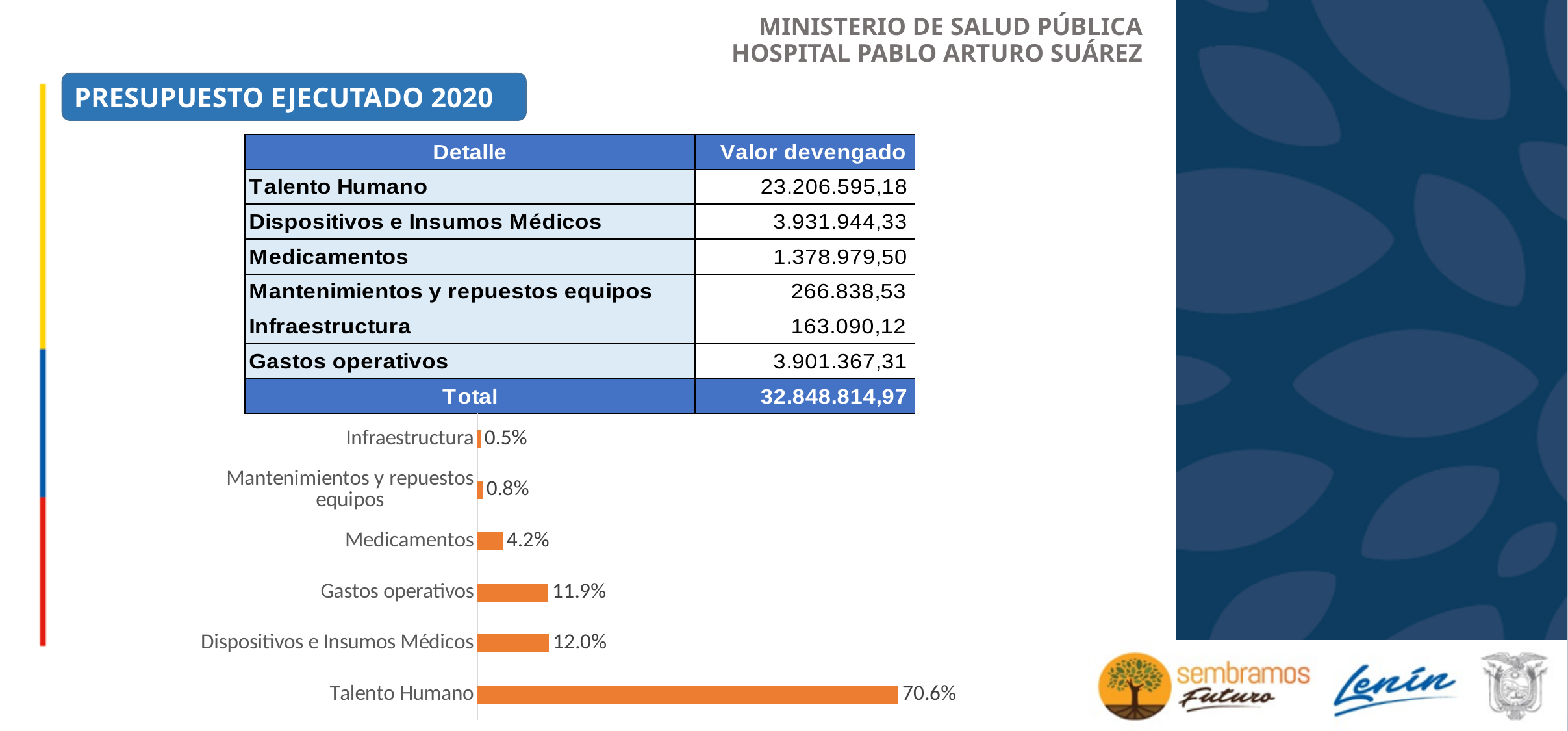
Which category has the highest percentage in the bar chart? Talento Humano How many categories are shown in the bar chart? 6 In the bar chart, which is larger: Medicamentos or Mantenimientos y repuestos equipos? Medicamentos What percentage does the bar chart show for Gastos operativos? 11.9% What percentage does the bar chart show for Medicamentos? 4.2% What percentage does the bar chart show for Talento Humano? 70.6% What is the difference in percentage points between Dispositivos e Insumos Médicos and Gastos operativos in the bar chart? 0.1% What colour are the bars in the chart? Orange What is the difference in percentage points between Talento Humano and Medicamentos in the bar chart? 66.4% Which category has the lowest percentage in the bar chart? Infraestructura What percentage does the bar chart show for Infraestructura? 0.5% What type of chart is shown on the slide? Bar chart